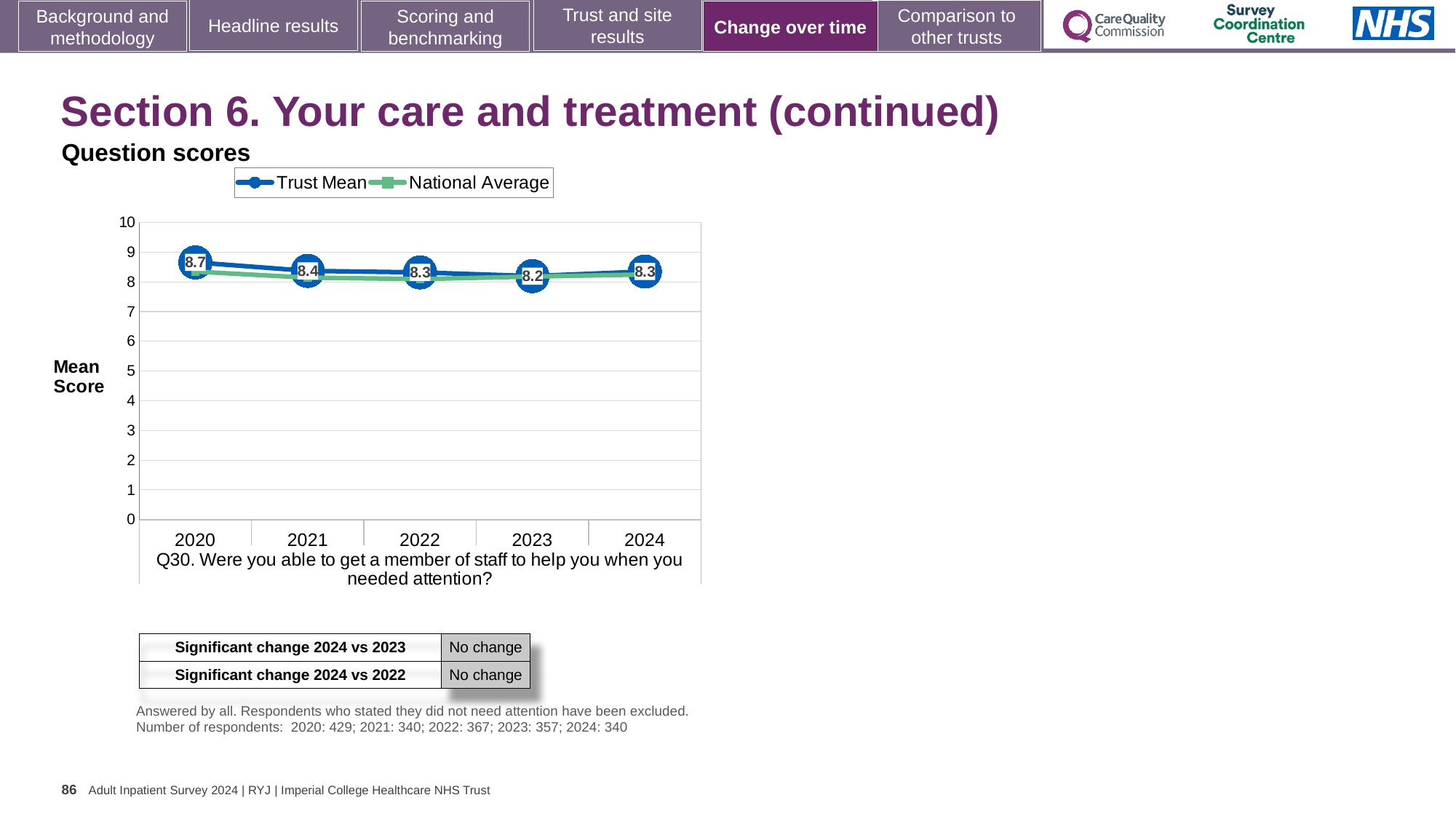
What kind of chart is shown on the slide? Line chart Does the Trust Mean score rise or fall from 2020 to 2023? Fall What is the Trust Mean score for 2024? 8.3 Which year has the larger Trust Mean score, 2020 or 2023? 2020 What is the difference between the Trust Mean score in 2020 and in 2024? 0.4 How many series does the legend list? 2 How many years are plotted on the x axis? 5 Is the National Average value for 2021 greater or less than 7? greater What is the Trust Mean score for 2023? 8.2 In which year is the Trust Mean score highest? 2020 In which year is the Trust Mean score lowest? 2023 What is the Trust Mean score for 2020? 8.7